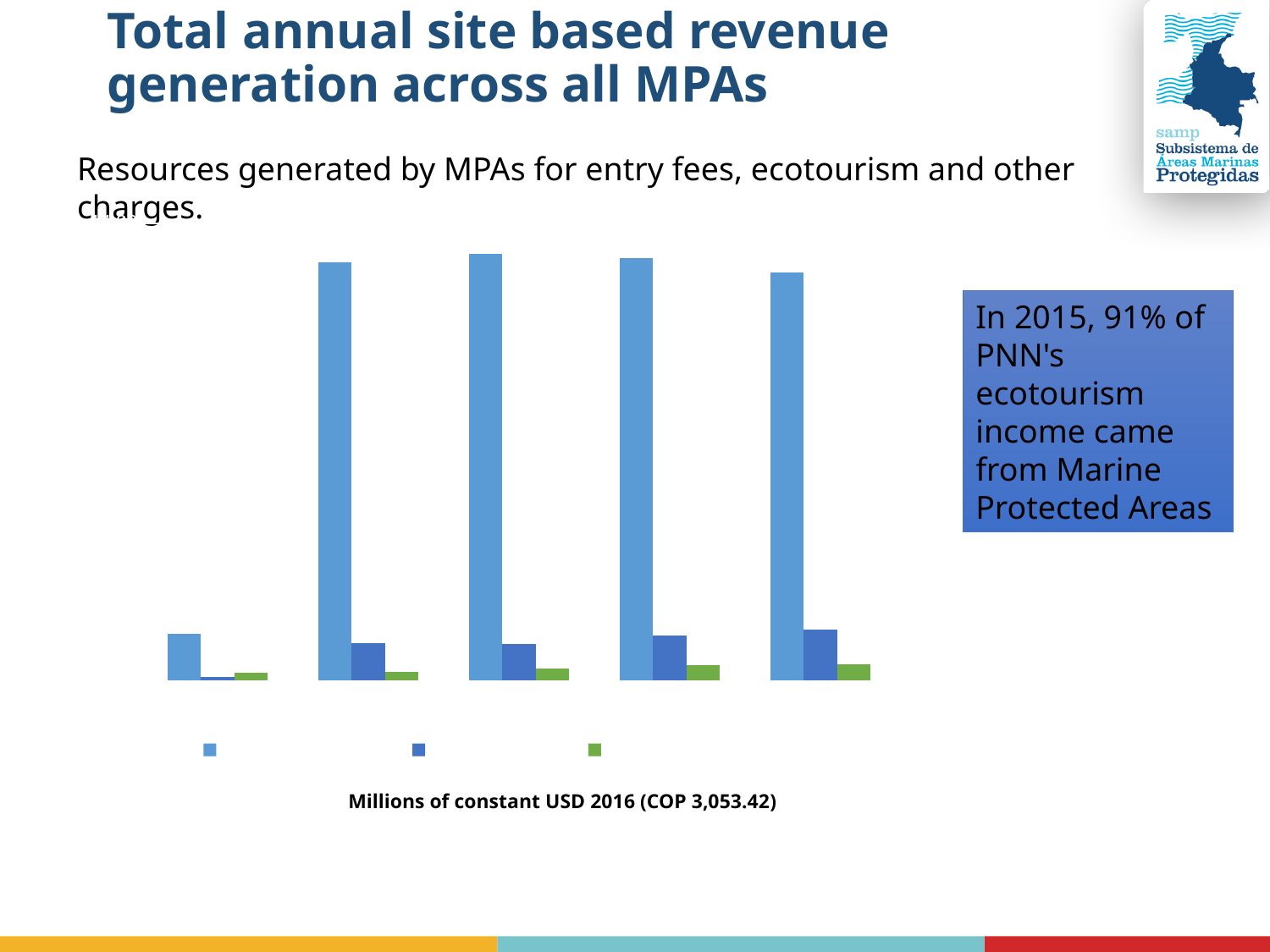
How many series does the chart's legend show? 3 How many groups of bars are plotted in the chart? 5 What kind of chart is shown on the slide? bar chart Is the light blue bar in the leftmost group taller or shorter than the light blue bar in the second group? shorter Counting from the left, which group has the tallest light blue bar? the third group In the leftmost group, is the light blue bar taller or shorter than the green bar? taller Counting from the left, which group has the shortest light blue bar? the first group Which colour of bar is the tallest in every group of the chart? light blue Is the dark blue bar in the fifth group taller or shorter than the dark blue bar in the first group? taller What unit caption is printed below the chart? Millions of constant USD 2016 (COP 3,053.42)